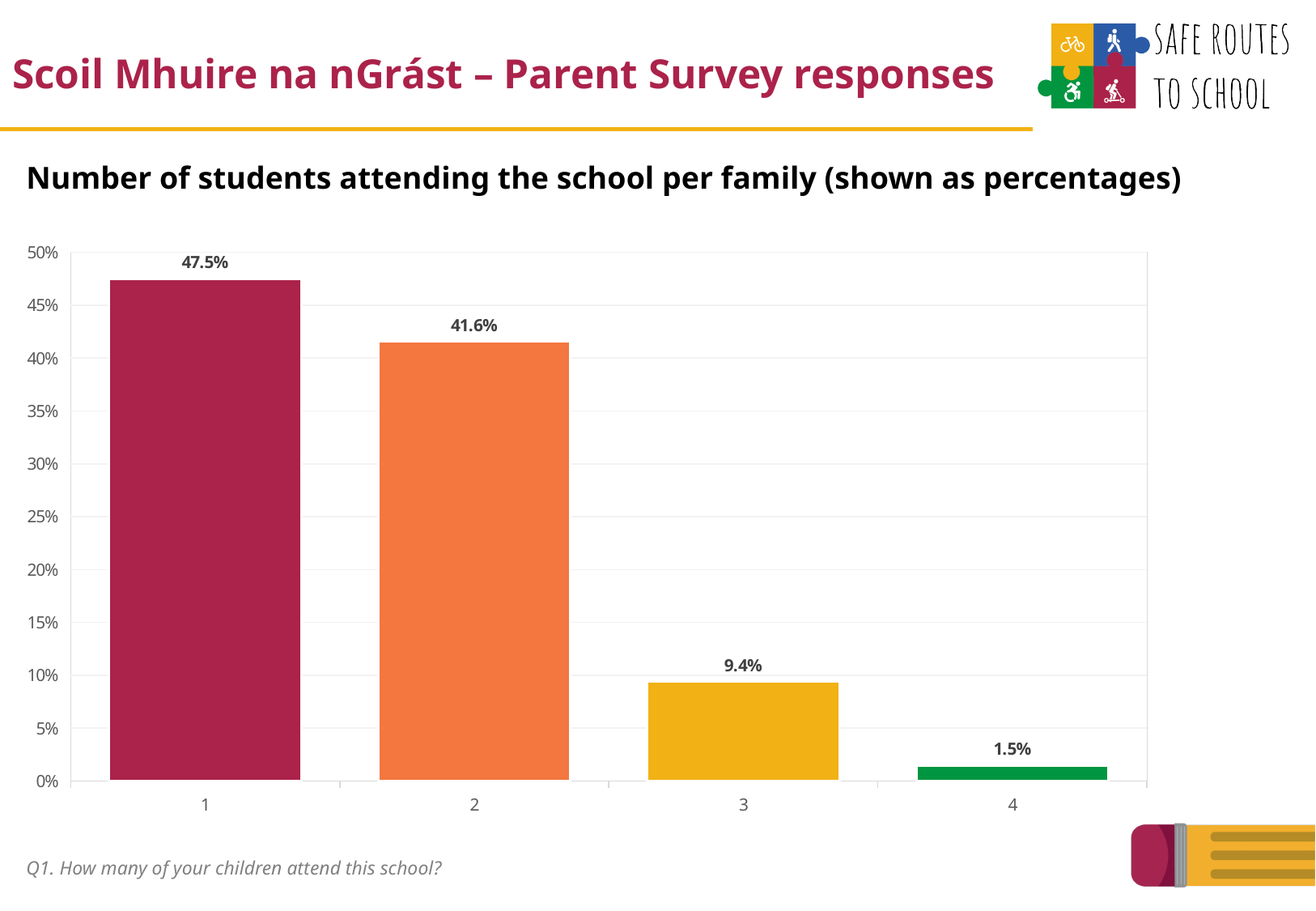
Which is larger: the percentage for 3 students or the percentage for 4 students? 3 students Do the values rise or fall as the number of students per family increases along the x axis? Fall What percentage of families have 2 students attending the school? 41.6% Which number of students per family has the highest percentage? 1 Which number of students per family has the lowest percentage? 4 What kind of chart is shown on the slide? Bar chart What percentage of families have 3 students attending the school? 9.4% What percentage of families have 4 students attending the school? 1.5% What is the difference in percentage points between families with 1 student and families with 2 students? 5.9% How many categories are shown on the x axis? 4 Is the value for 2 students greater or less than 40%? greater What percentage of families have 1 student attending the school? 47.5%